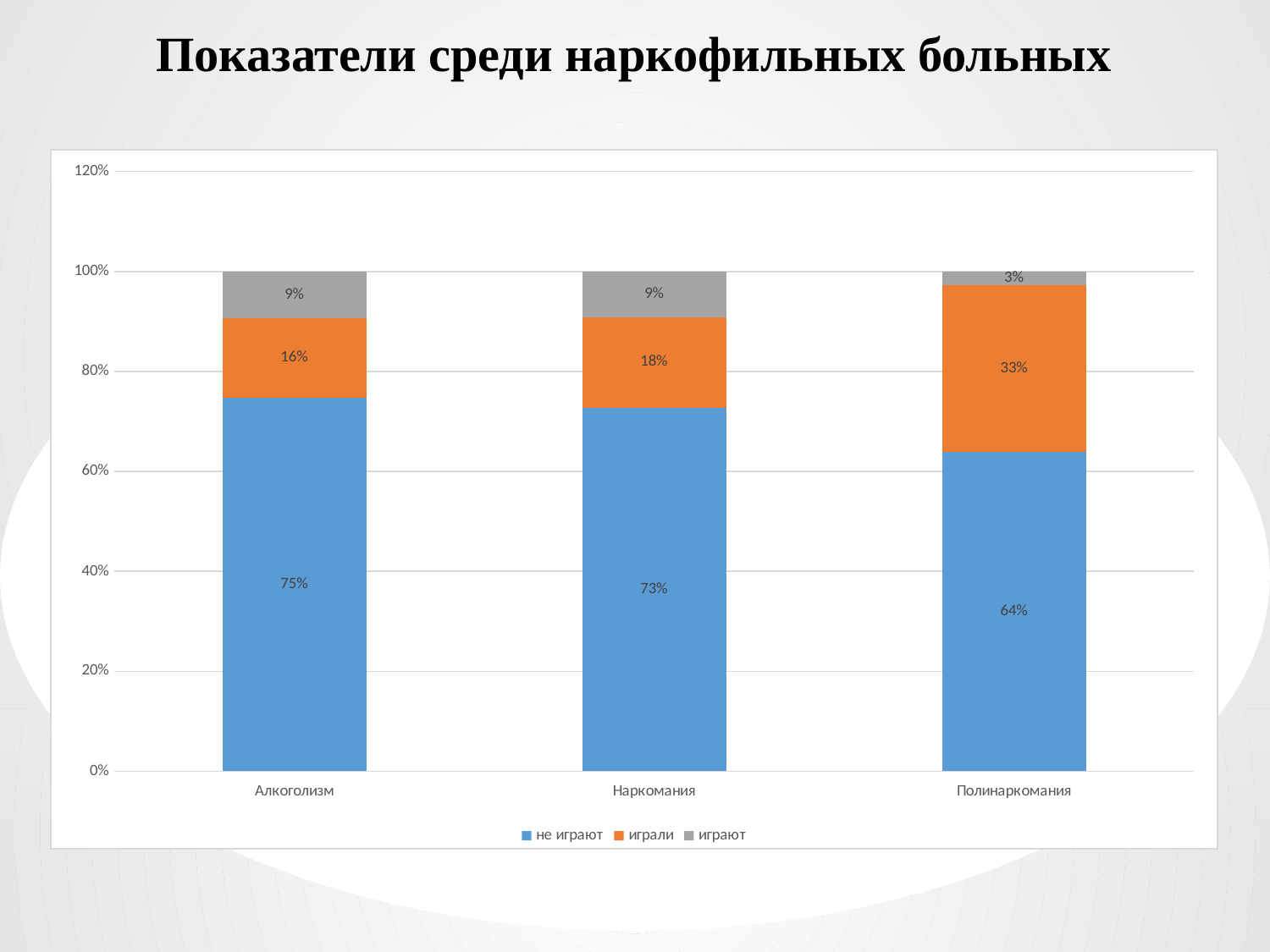
What is the total of the stacked bar for Полинаркомания? 100% How many series does the legend list? 3 What is the title of the slide? Показатели среди наркофильных больных What is the value for "играли" in the Полинаркомания category? 33% How many categories are shown on the x axis? 3 What kind of chart is shown on the slide? Stacked bar chart Which category has the lowest value for "играют"? Полинаркомания What is the difference between the "играли" values for Полинаркомания and Алкоголизм? 17% Which is larger: the "не играют" value for Наркомания or for Полинаркомания? Наркомания What is the value for "не играют" in the Алкоголизм category? 75% What is the value for "играют" in the Наркомания category? 9% Which category has the highest value for "не играют"? Алкоголизм